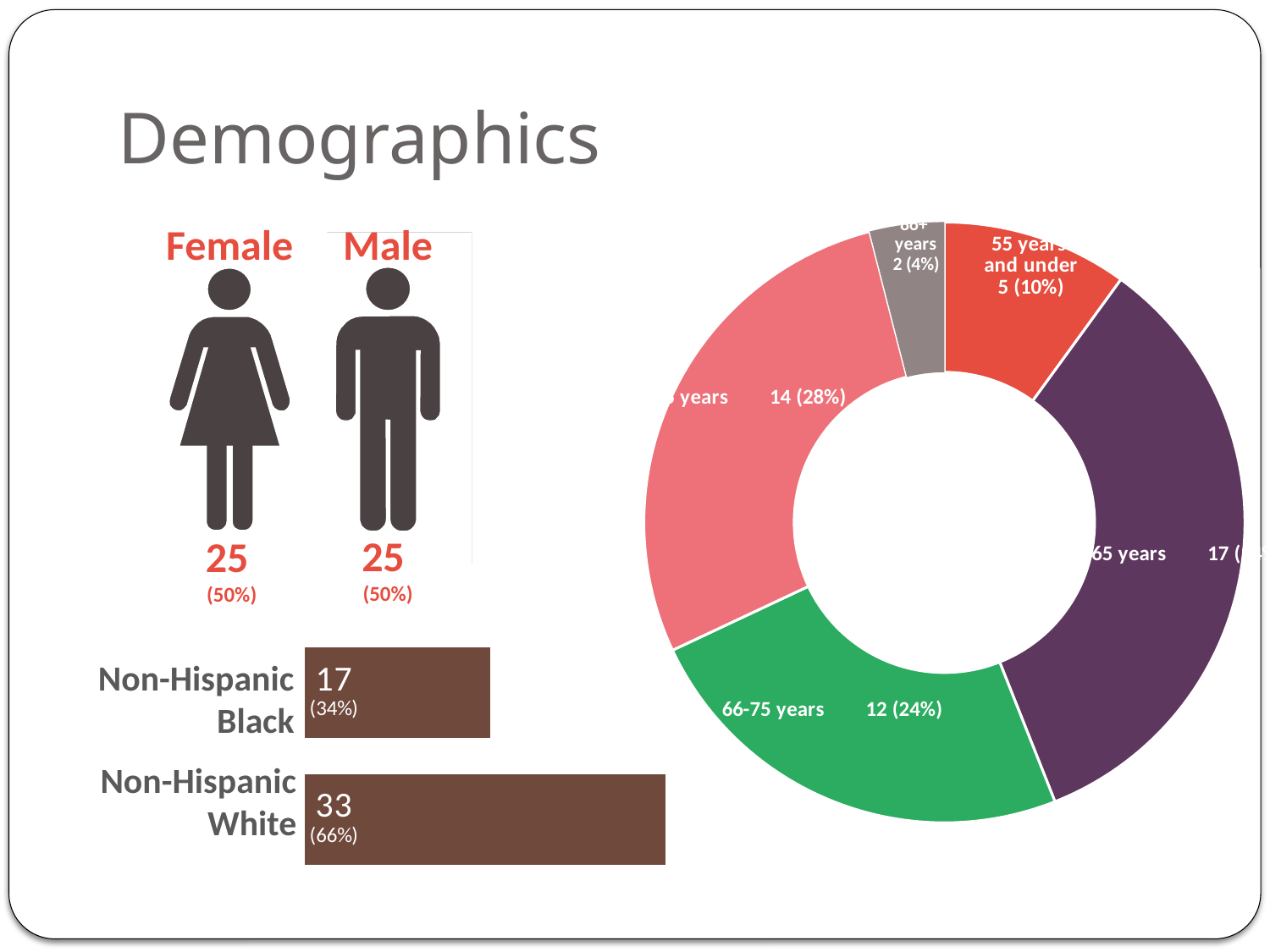
In the age chart on the right, what is the value for 55 years and under? 5 (10%) What kind of chart is the age chart on the right of the slide? Doughnut (pie) chart In the bar chart on the left, what percentage is shown for Non-Hispanic White? 66% In the bar chart on the left, which category has the larger value, Non-Hispanic Black or Non-Hispanic White? Non-Hispanic White What kind of chart is the race chart on the left of the slide? Bar chart In the bar chart on the left, what is the value for Non-Hispanic White? 33 In the bar chart on the left, what is the value for Non-Hispanic Black? 17 In the age chart on the right, what is the value for 66-75 years? 12 (24%) In the age chart on the right, what share of the total is the 66-75 years slice? 24% In the bar chart on the left, what is the difference between the Non-Hispanic White and Non-Hispanic Black values? 16 How many categories does the bar chart on the left show? 2 In the age chart on the right, which slice is larger, 55 years and under or 66-75 years? 66-75 years